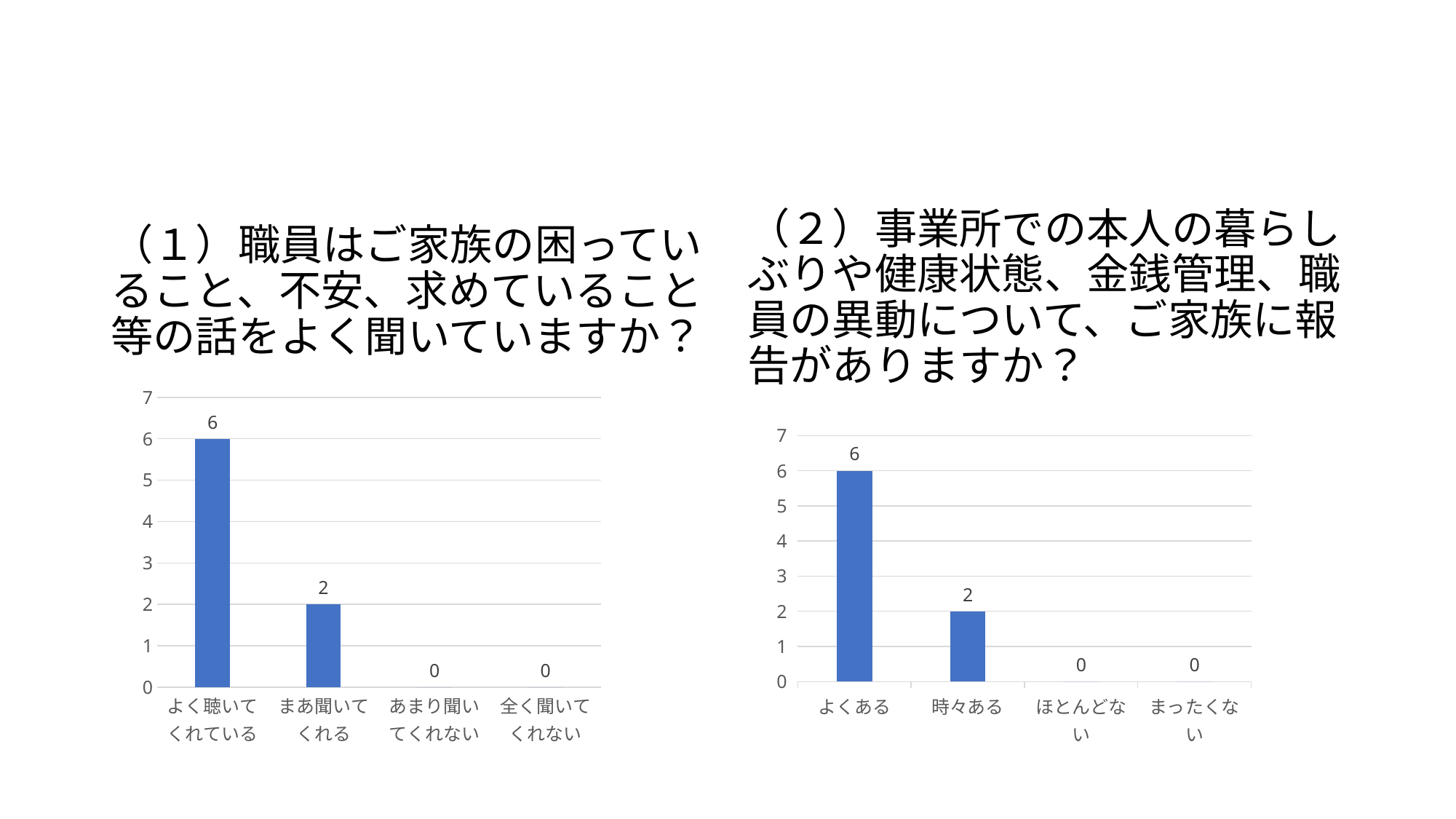
In the right chart (2), which is larger, よくある or 時々ある? よくある In the left chart (1), what is the value for あまり聞いてくれない? 0 In the right chart (2), what is the value for まったくない? 0 In the left chart (1), how many categories are shown on the x axis? 4 In the left chart (1), which category has the highest value? よく聴いてくれている What kind of chart is the right chart (2)? bar chart In the right chart (2), what is the value for よくある? 6 In the left chart (1), what is the value for よく聴いてくれている? 6 In the left chart (1), what is the value for まあ聞いてくれる? 2 In the right chart (2), what is the value for 時々ある? 2 In the right chart (2), do the values rise or fall from left to right along the x axis? fall In the left chart (1), what is the difference between よく聴いてくれている and まあ聞いてくれる? 4